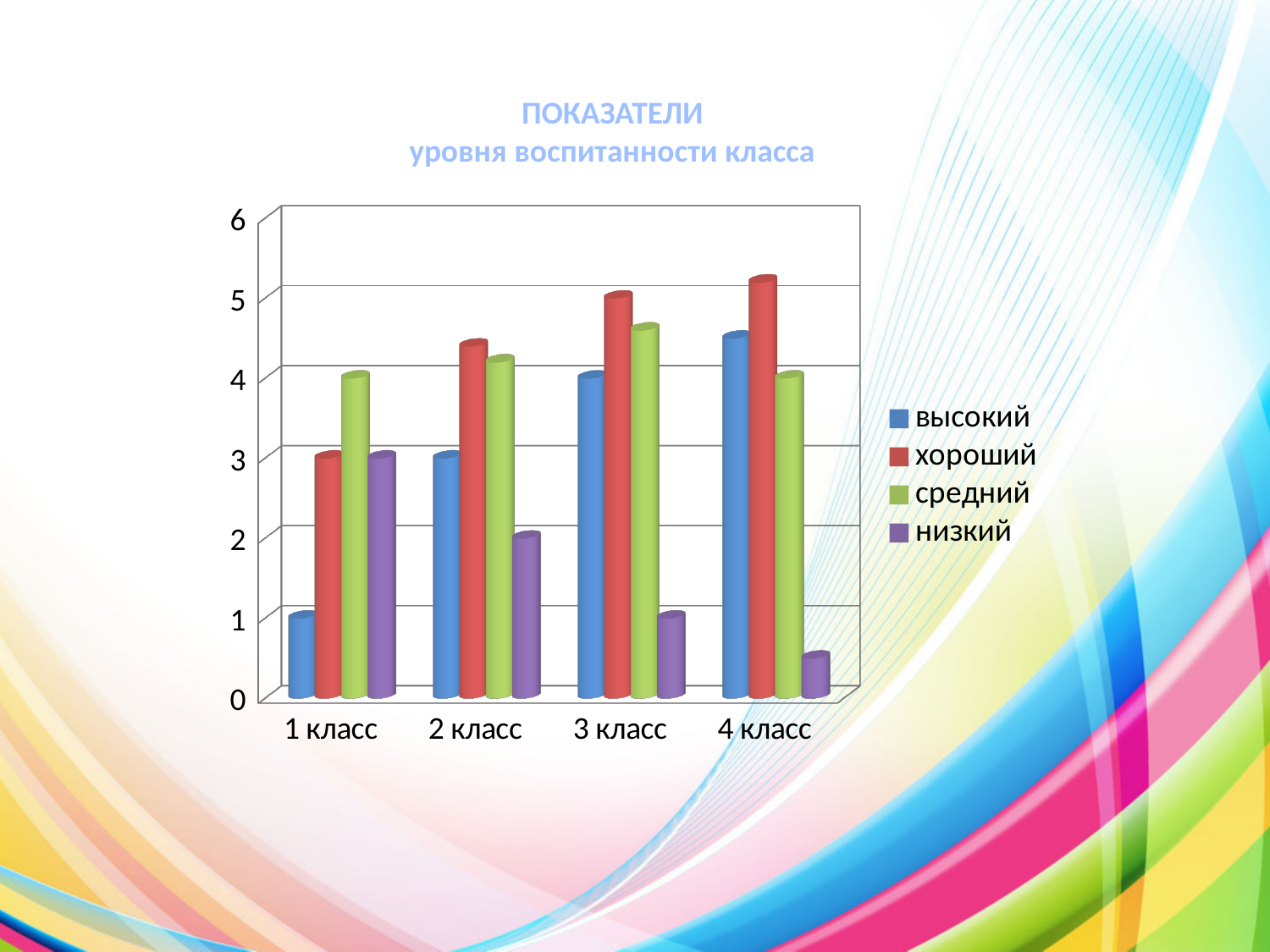
Which category has the lowest value for высокий? 1 класс What kind of chart is shown on the slide? bar chart Which is larger in 1 класс: the value for высокий or the value for средний? средний How many categories are shown on the x axis? 4 How many series does the legend list? 4 Which series is shown in purple in the legend? низкий Is the value for хороший in 2 класс greater or less than 4? greater Do the values for высокий rise or fall from 1 класс to 4 класс? rise Which category has the highest value for хороший? 4 класс Is the value for высокий in 4 класс greater or less than 4? greater Is the value for низкий in 4 класс greater or less than 1? less